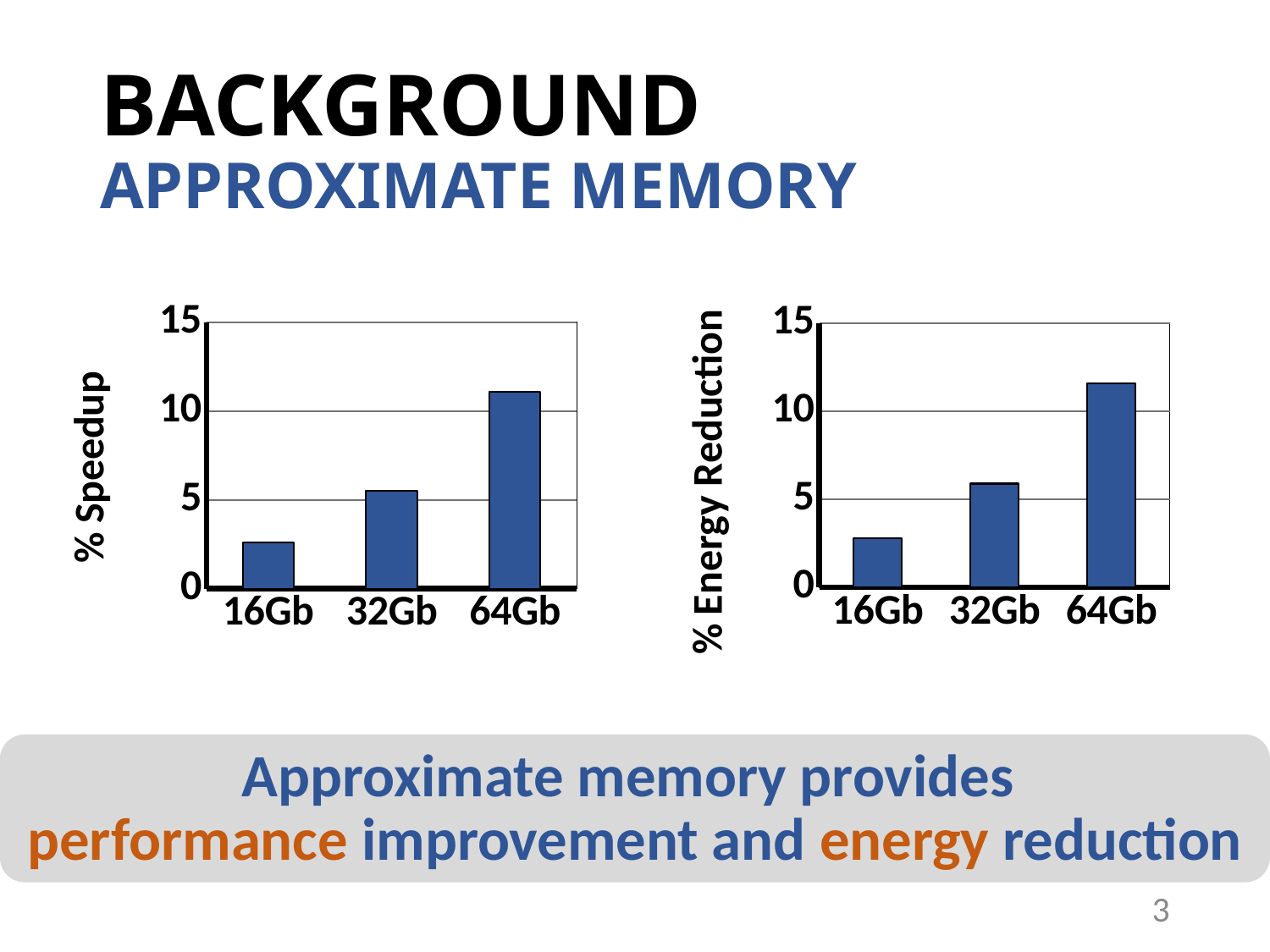
In the % Speedup chart on the left, which category has the lowest value? 16Gb In the % Speedup chart on the left, do the values rise or fall from 16Gb to 64Gb? rise In the % Energy Reduction chart on the right, is the value for 32Gb greater or less than 10? less In the % Energy Reduction chart on the right, which category has the highest value? 64Gb In the % Energy Reduction chart on the right, is the value for 64Gb greater or less than 10? greater In the % Speedup chart on the left, which category has the highest value? 64Gb What is the y-axis label of the chart on the right? % Energy Reduction What kind of chart is the % Speedup chart on the left? bar chart In the % Energy Reduction chart on the right, which is larger, the value for 16Gb or the value for 32Gb? 32Gb In the % Speedup chart on the left, is the value for 16Gb greater or less than 5? less How many categories are shown on the x axis of the % Speedup chart on the left? 3